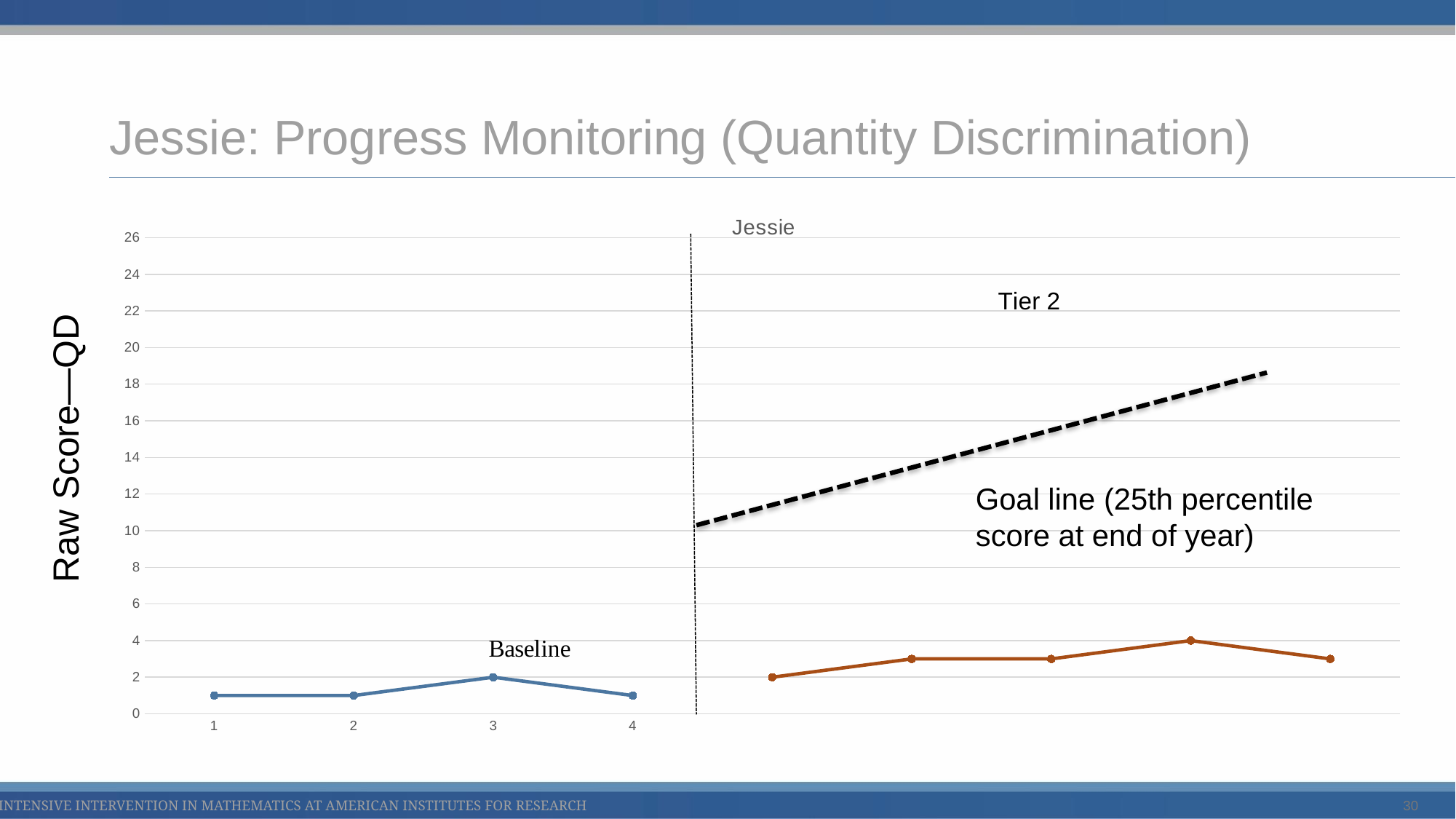
What kind of chart is shown on the slide? line chart Is the last Tier 2 data point greater or less than 4? less Does the dashed goal line rise or fall from left to right? rise What is the label on the vertical axis of the chart? Raw Score—QD Is the raw score at Baseline point 1 greater or less than 2? less Is the first Tier 2 data point greater or less than 4? less How many data points are plotted in the Baseline phase? 4 What is the title of the chart? Jessie What is the raw score at Baseline point 3? 2 How many data points are plotted in the Tier 2 phase? 5 Which is larger: the highest Tier 2 score or the score at Baseline point 3? the highest Tier 2 score What is the highest raw score reached during the Tier 2 phase? 4